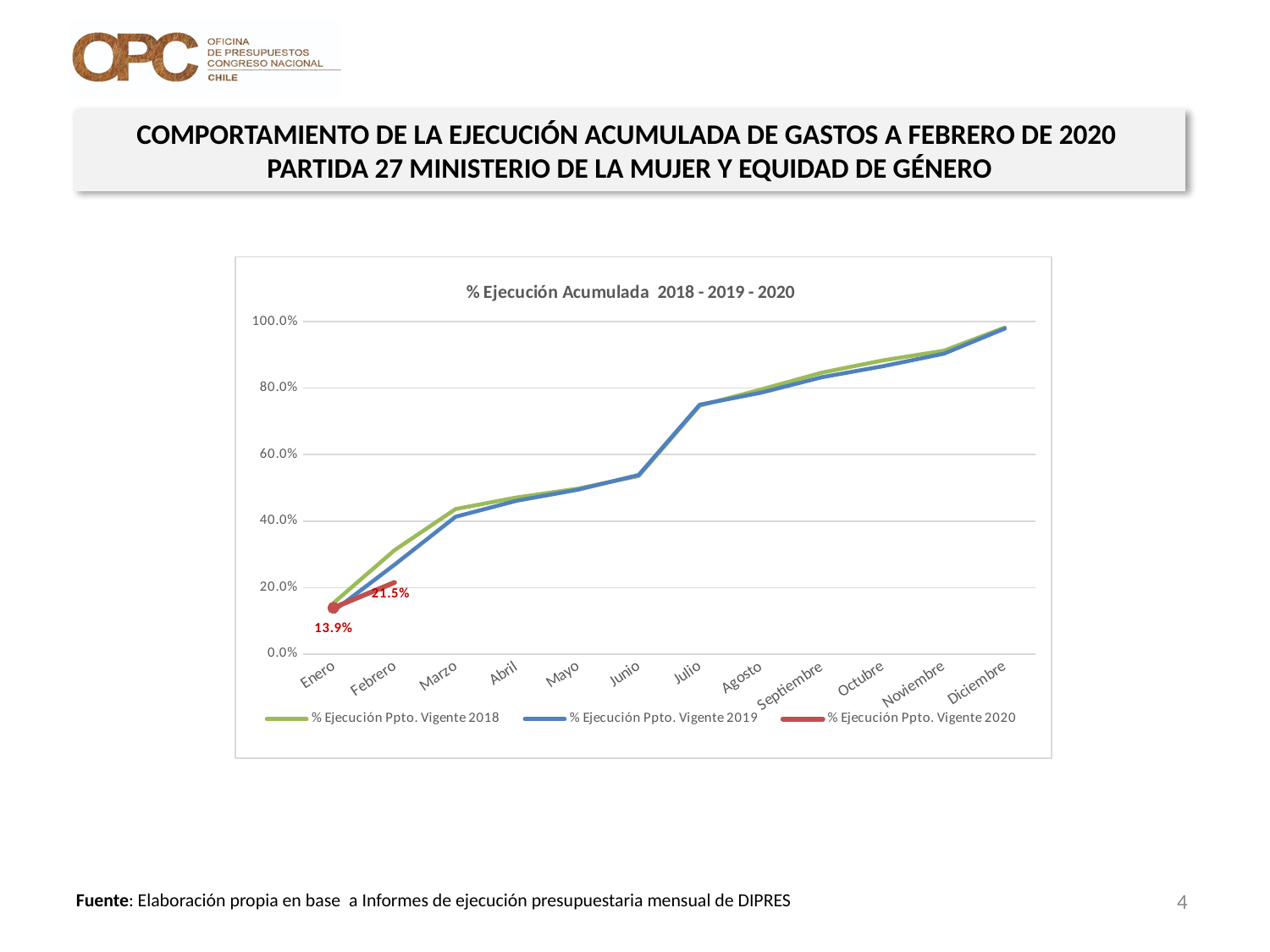
How many series does the chart legend list? 3 Do the 2018 and 2019 series rise or fall from Enero to Diciembre? rise Which is larger for the 2020 series: the value for Enero or the value for Febrero? Febrero What kind of chart is shown on the slide? line chart By how many percentage points did % Ejecución Ppto. Vigente 2020 increase from Enero to Febrero? 7.6 percentage points How many months are shown along the x axis? 12 Is the value for % Ejecución Ppto. Vigente 2019 in Diciembre greater or less than 80%? greater Is the value for % Ejecución Ppto. Vigente 2018 in Marzo greater or less than 60%? less What is the value of % Ejecución Ppto. Vigente 2020 for Enero? 13.9% What is the value of % Ejecución Ppto. Vigente 2020 for Febrero? 21.5% What is the title of the chart? % Ejecución Acumulada 2018 - 2019 - 2020 Is the value for % Ejecución Ppto. Vigente 2019 in Julio greater or less than 60%? greater